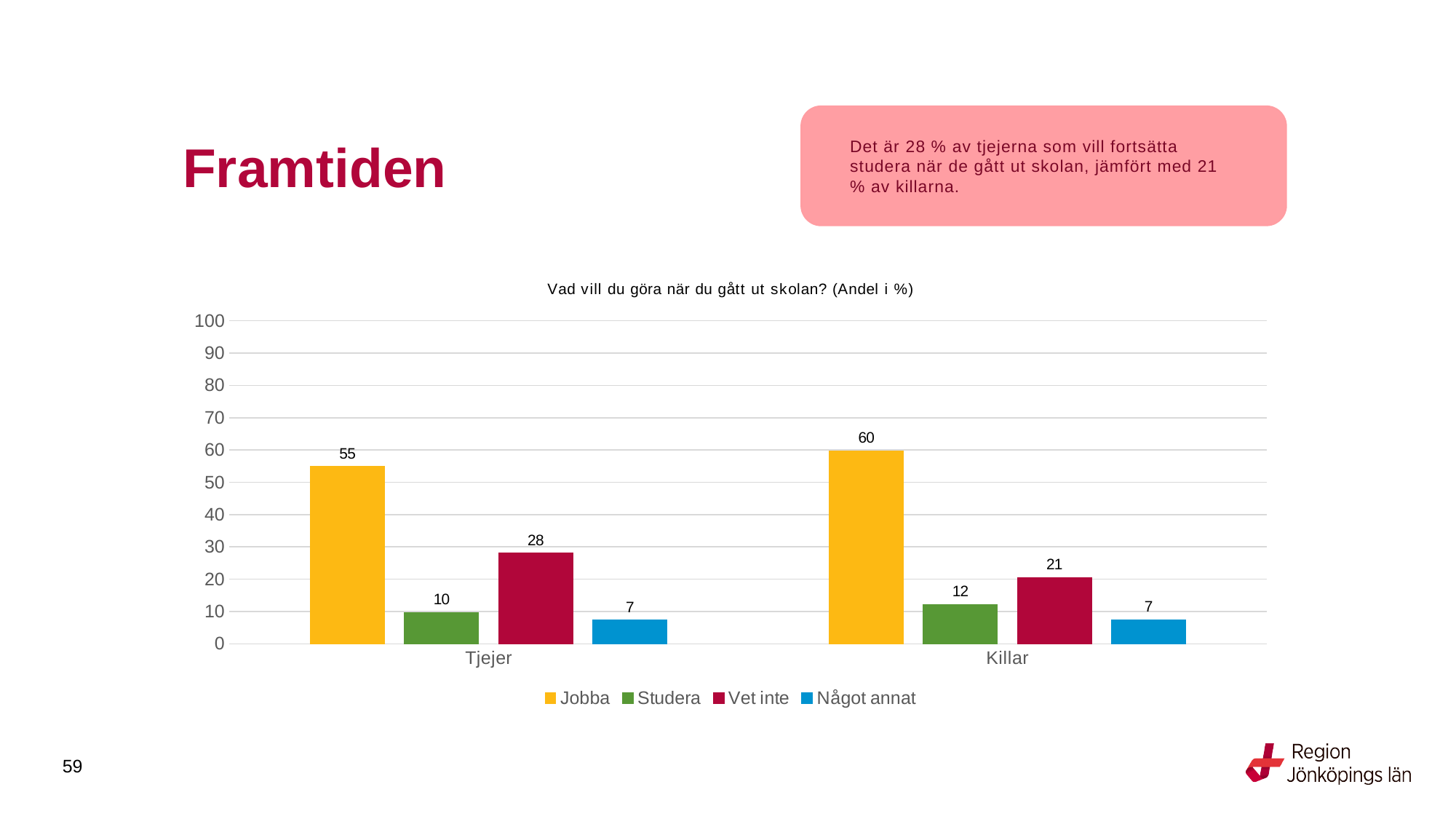
What is the difference between the Vet inte values for Tjejer and Killar? 7 Which series has the highest value in the Killar group? Jobba What kind of chart is shown on the slide? Bar chart Which is larger, Studera for Tjejer or Studera for Killar? Studera for Killar What is the value for Vet inte in the Killar group? 21 What is the value for Studera in the Killar group? 12 What is the title of the chart? Vad vill du göra när du gått ut skolan? (Andel i %) Which series has the lowest value in the Tjejer group? Något annat Is the value for Jobba in the Killar group greater or less than 50? greater What is the difference between the Jobba values for Killar and Tjejer? 5 What is the value for Jobba in the Tjejer group? 55 How many series does the legend list? 4